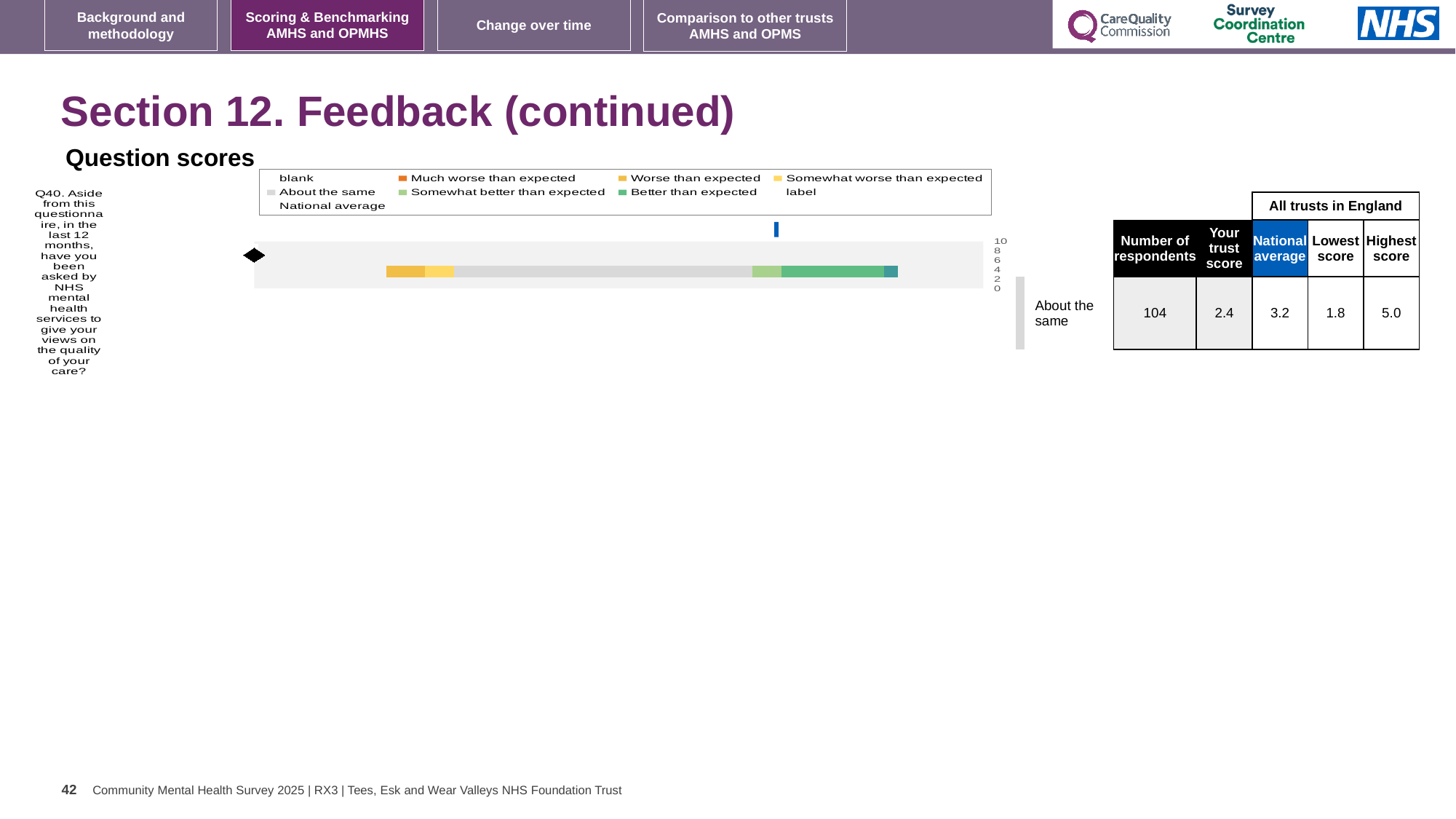
Which question is plotted in the chart? Q40 In the table beside the chart, what is the highest score among all trusts in England for Q40? 5.0 In the table beside the chart, what is the trust score for Q40? 2.4 How many entries does the chart legend list? 9 In the table beside the chart, what is the national average for Q40? 3.2 In the table beside the chart, what is the number of respondents for Q40? 104 What is the title above the chart? Question scores What kind of chart is shown on the slide? bar chart In the table beside the chart, is the trust score for Q40 larger or smaller than the national average? smaller In the table beside the chart, what is the difference between the highest score and the lowest score for Q40? 3.2 What rating label is shown to the right of the chart for Q40? About the same How many questions (categories) are plotted in the chart? 1